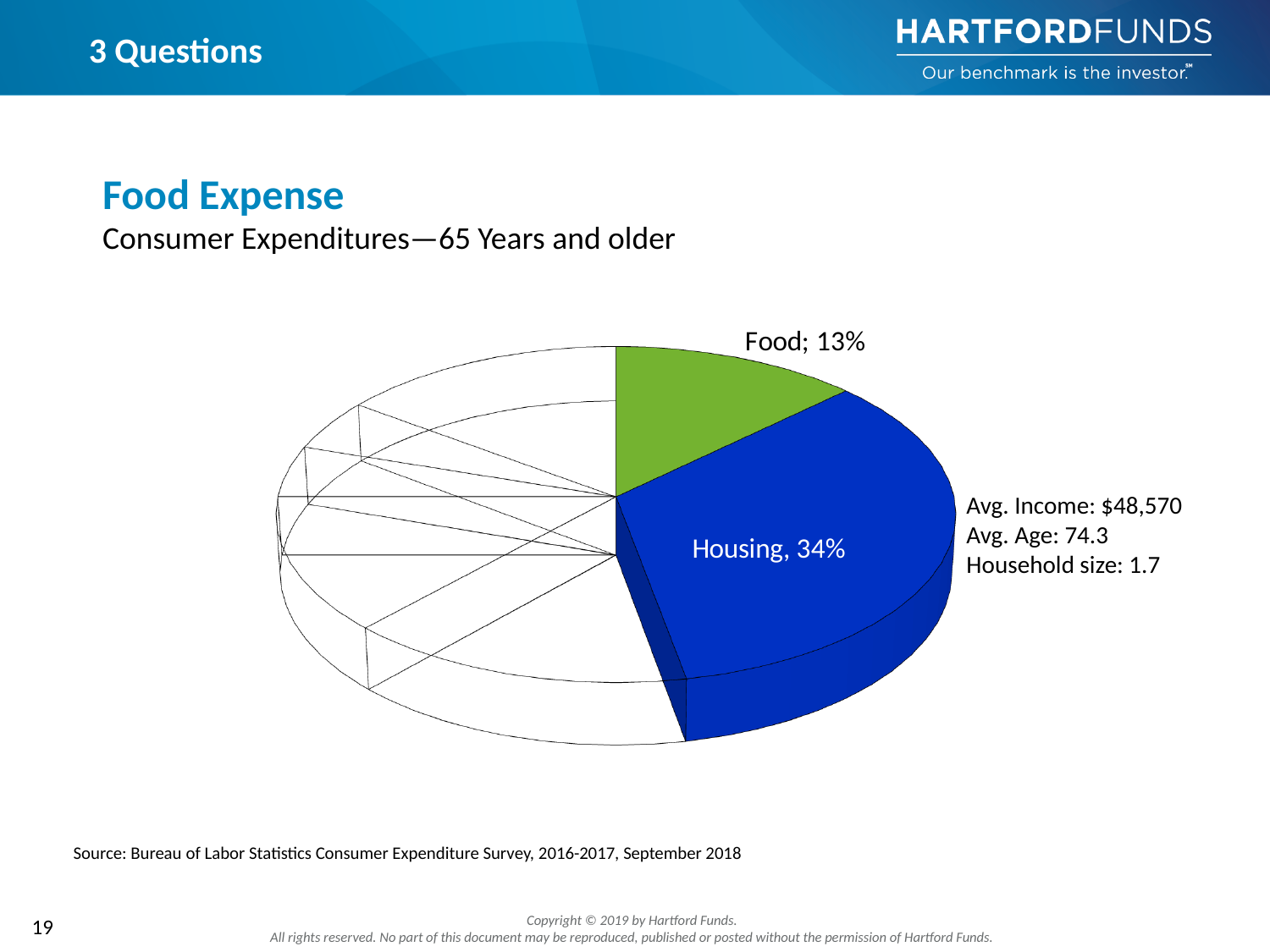
What colour is the Food slice of the pie? Green What kind of chart is shown on the slide? Pie chart Which slice of the pie is the largest? Housing What percentage of consumer expenditures for those 65 years and older goes to Food? 13% By how many percentage points does the Housing share exceed the Food share? 21 percentage points What is the combined share of the Food and Housing slices? 47% Which of the two labeled slices is larger, Food or Housing? Housing What is the subtitle of the chart beneath the heading 'Food Expense'? Consumer Expenditures—65 Years and older What percentage of consumer expenditures for those 65 years and older goes to Housing? 34% What share of the pie does the Food slice represent? 13%